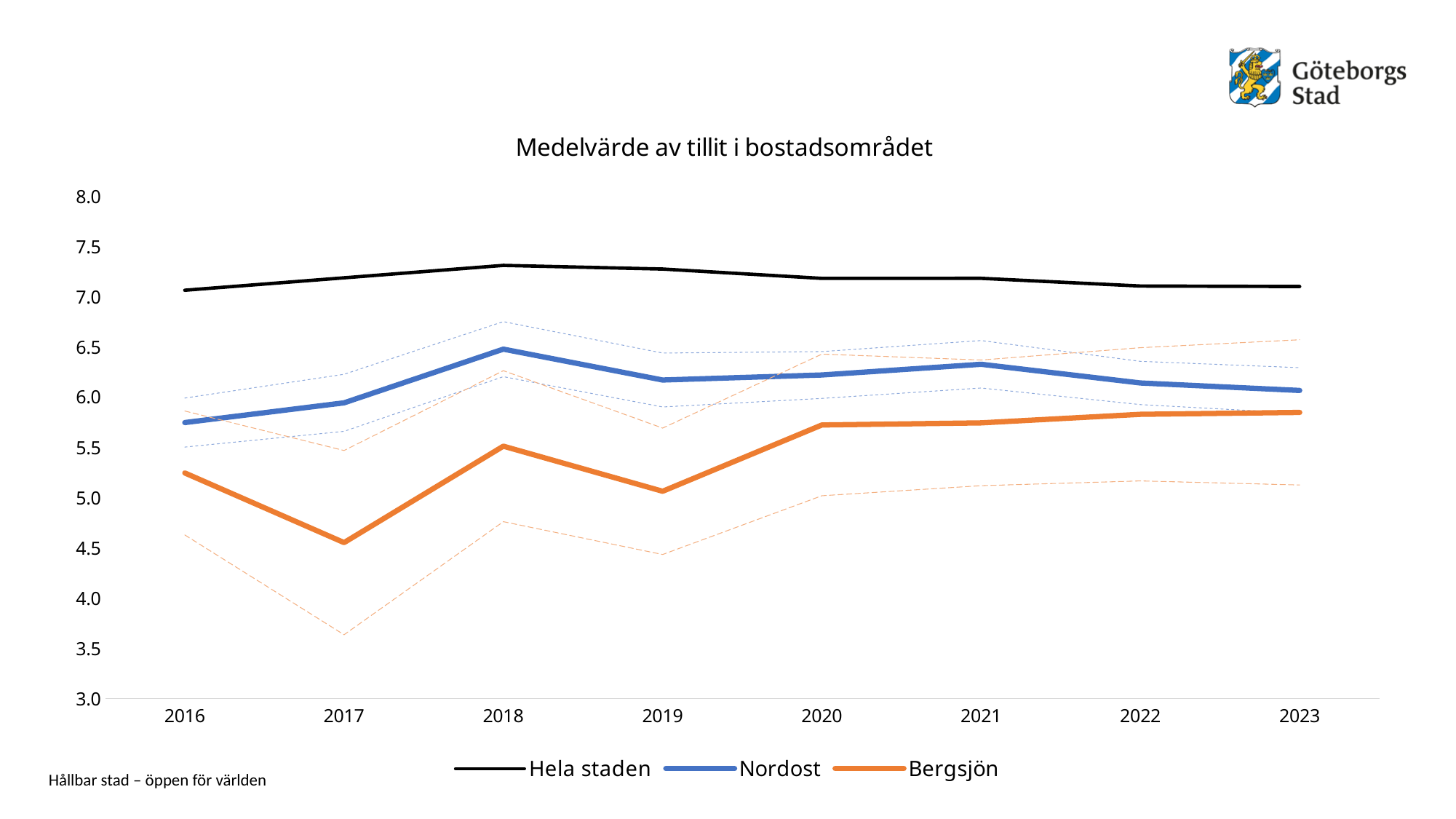
In which year is the value for Nordost highest? 2018 What kind of chart is shown on the slide? Line chart Which colour is used for the Bergsjön line? Orange Is the value for Bergsjön in 2017 greater or less than 5.0? less How many series does the legend list? 3 Is the value for Hela staden in 2016 greater or less than 7.0? greater In which year is the value for Nordost lowest? 2016 In which year is the value for Bergsjön lowest? 2017 How many years are shown on the x axis? 8 Which is larger in 2023, the value for Hela staden or the value for Nordost? Hela staden Does the value for Bergsjön rise or fall from 2019 to 2023? Rise What is the title of the chart? Medelvärde av tillit i bostadsområdet